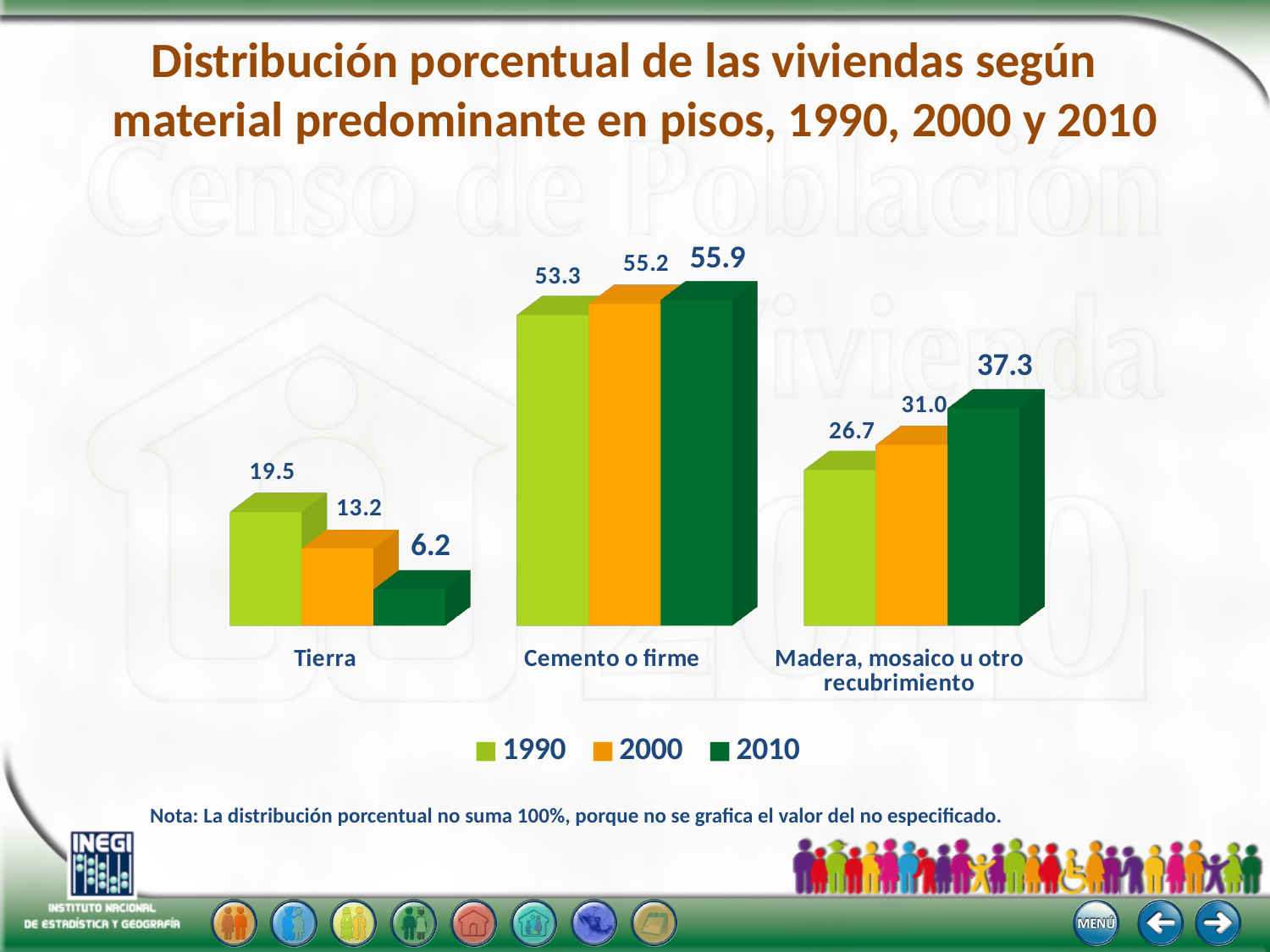
How many categories are shown on the x axis? 3 What is the value for Tierra in 1990? 19.5 What is the value for Cemento o firme in 2010? 55.9 What is the difference between the 1990 and 2010 values for Tierra? 13.3 What is the value for Madera, mosaico u otro recubrimiento in 2000? 31.0 What kind of chart is shown on the slide? Bar chart What is the difference between the 2010 and 1990 values for Madera, mosaico u otro recubrimiento? 10.6 How many series does the legend list? 3 Which is larger: the 2000 value for Tierra or the 2000 value for Madera, mosaico u otro recubrimiento? Madera, mosaico u otro recubrimiento Which category has the lowest value in 1990? Tierra Which category has the highest value in 2010? Cemento o firme Do the values for Tierra rise or fall from 1990 to 2010? Fall